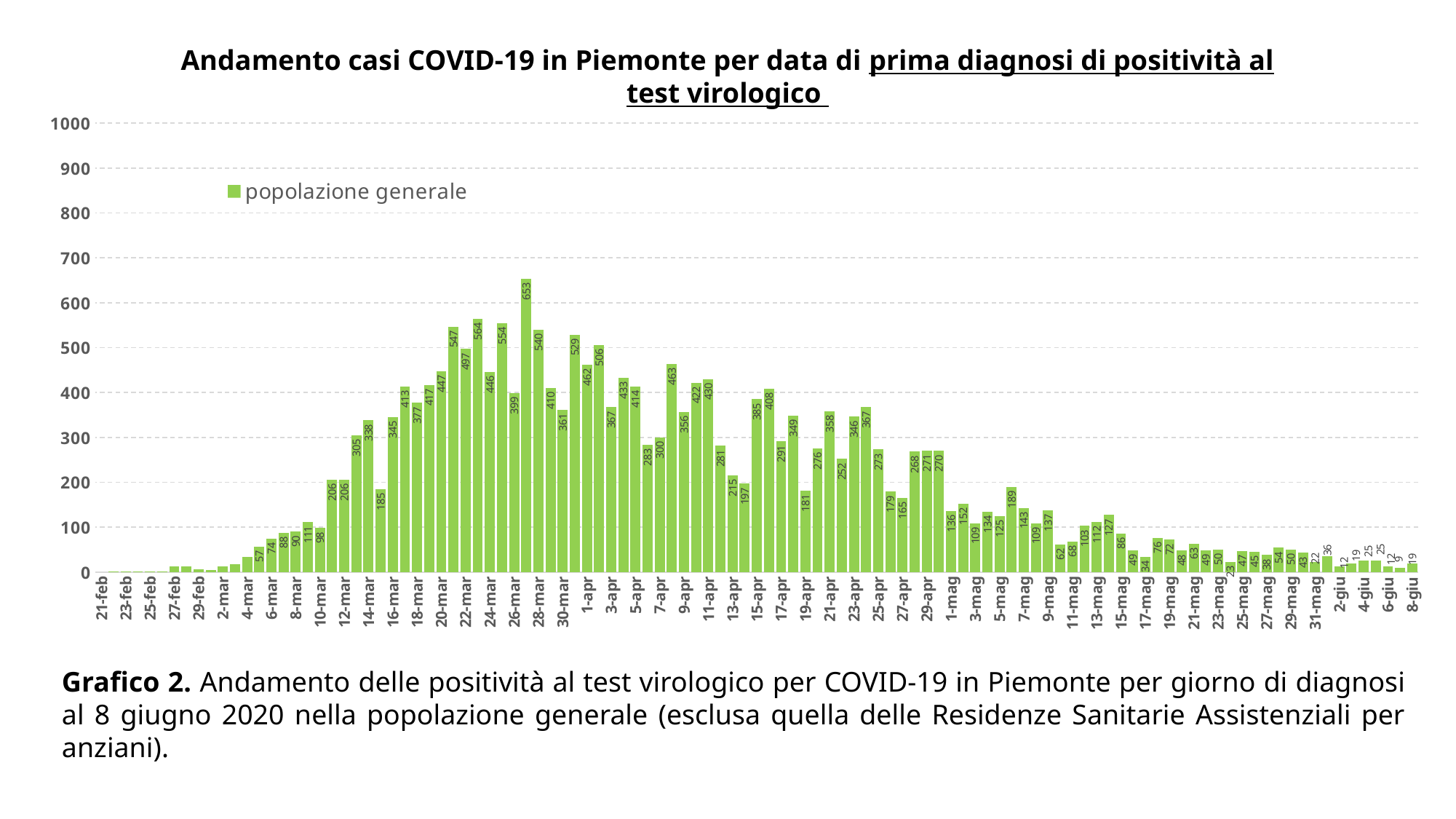
Which is larger, the value for 8-giu or the highest value in late March? the highest value in late March What is the difference between the highest daily value (653) and the value for 8-giu (19)? 634 What kind of chart is shown on the slide? bar chart What is the name of the series shown in the legend? popolazione generale Is the value for 21-feb greater or less than 100? less How many series does the legend list? 1 What is the maximum value shown on the y axis? 1000 Is the value for 8-giu greater or less than 100? less What is the value for 8-giu, the last date on the x axis? 19 Do the values generally rise or fall from mid-April to 8-giu? fall Is the value for 12-mar greater or less than 200? greater What is the highest daily value shown in the chart? 653